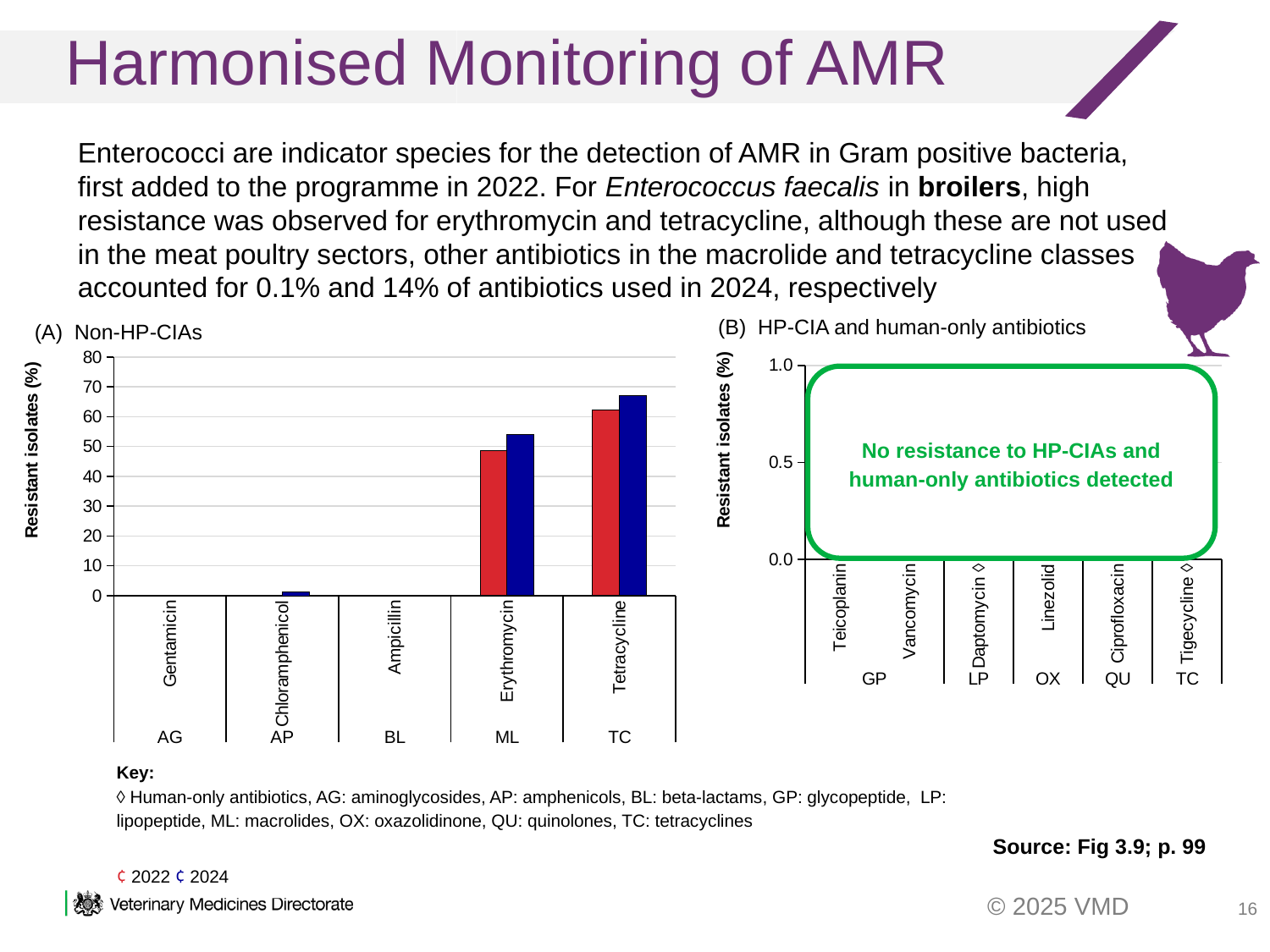
In chart (B) HP-CIA and human-only antibiotics, how many antibiotics are listed on the x axis? 6 In chart (A) Non-HP-CIAs, which antibiotic has the highest percentage of resistant isolates? Tetracycline In chart (A) Non-HP-CIAs, what kind of chart is shown? bar chart In chart (A) Non-HP-CIAs, which is larger for Erythromycin: the 2022 value or the 2024 value? 2024 In chart (A) Non-HP-CIAs, is the 2022 value for Erythromycin greater or less than 50? less In chart (A) Non-HP-CIAs, is the 2024 value for Chloramphenicol greater or less than 10? less In chart (A) Non-HP-CIAs, is the 2024 value for Erythromycin greater or less than 50? greater In chart (B) HP-CIA and human-only antibiotics, what does the boxed text on the chart say? No resistance to HP-CIAs and human-only antibiotics detected In chart (A) Non-HP-CIAs, how many antibiotic categories are shown on the x axis? 5 In chart (A) Non-HP-CIAs, which is larger: the 2022 value for Tetracycline or the 2024 value for Erythromycin? 2022 value for Tetracycline In chart (A) Non-HP-CIAs, how many series does the legend list? 2